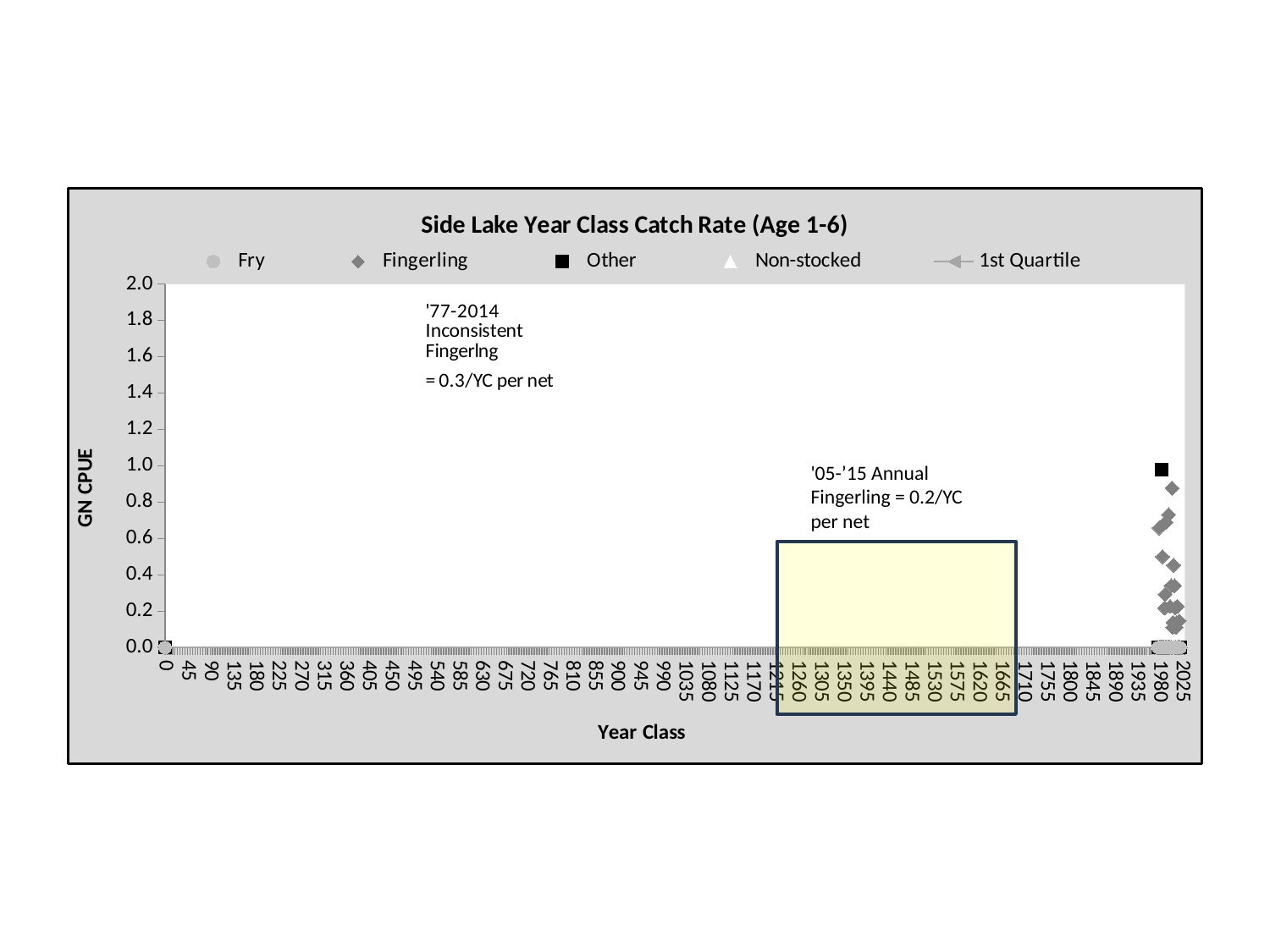
According to the annotation, what was the '77-2014 Inconsistent Fingerling catch rate per net? 0.3/YC per net Is the value of the Other (black square) point greater or less than 0.5? greater What is the title of the chart? Side Lake Year Class Catch Rate (Age 1-6) What is the maximum value shown on the y axis? 2.0 Which series has the single highest plotted point, Other or Fingerling? Other Is the highest Fingerling point greater or less than 1.0? less What is the label of the y axis? GN CPUE Is the lowest Fingerling point greater or less than 0.4? less What kind of chart is shown on the slide? scatter chart According to the annotation, what was the '05-'15 Annual Fingerling catch rate per net? 0.2/YC per net How many series does the chart legend list? 5